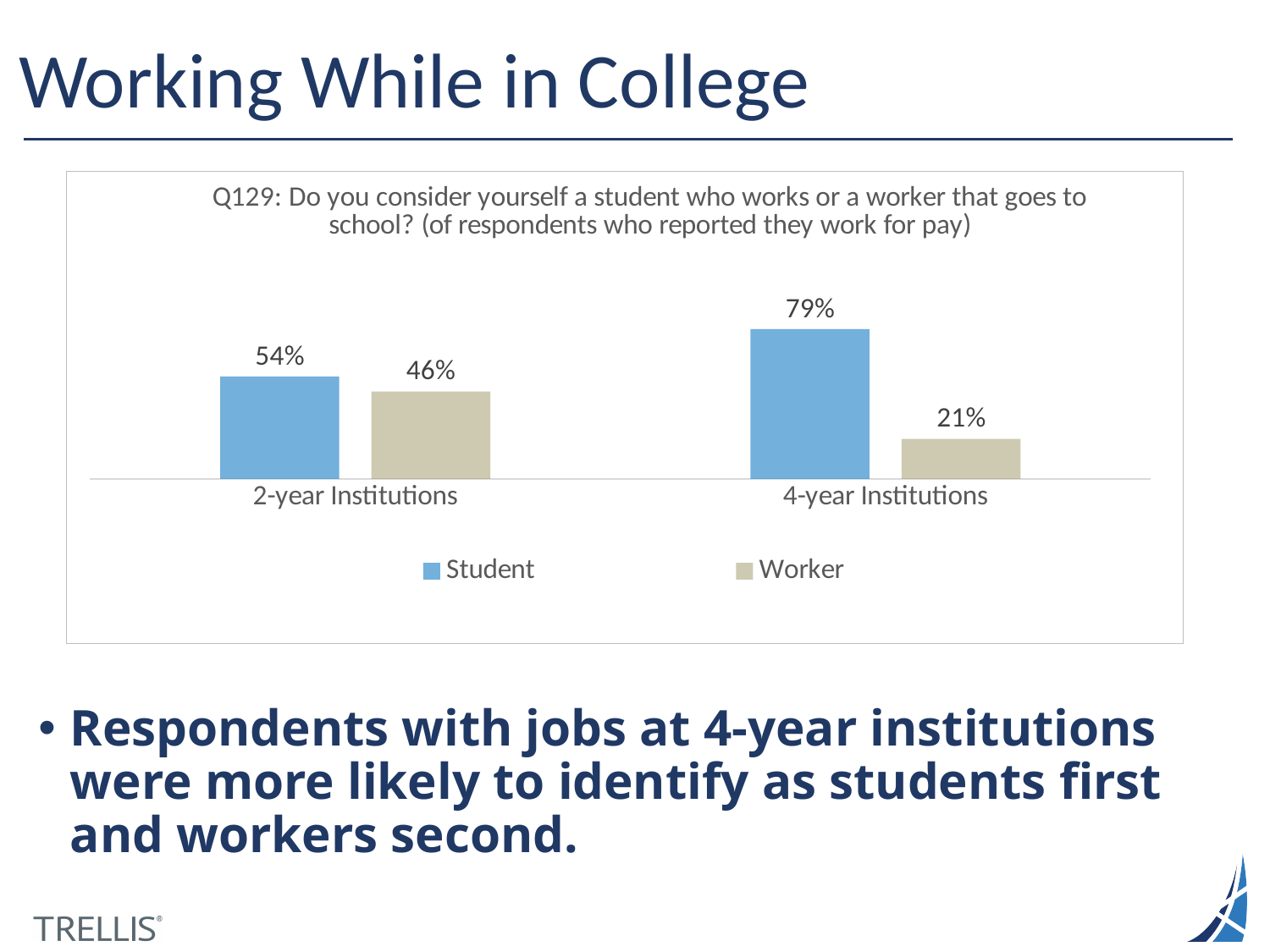
Which colour represents the Worker series in the chart? Tan (beige) What is the Worker value for 2-year institutions? 46% Which bar in the chart has the highest value? Student, 4-year Institutions What percentage of respondents at 4-year institutions consider themselves a worker that goes to school? 21% What is the difference between the Student percentages at 4-year and 2-year institutions? 25% What percentage of respondents at 2-year institutions consider themselves a student who works? 54% Which is larger: the Worker value for 2-year institutions or the Worker value for 4-year institutions? 2-year Institutions What type of chart is shown on the slide? Bar chart What is the difference between the Student and Worker percentages at 4-year institutions? 58% Which bar in the chart has the lowest value? Worker, 4-year Institutions How many series does the legend list? 2 What is the Student value for 4-year institutions? 79%